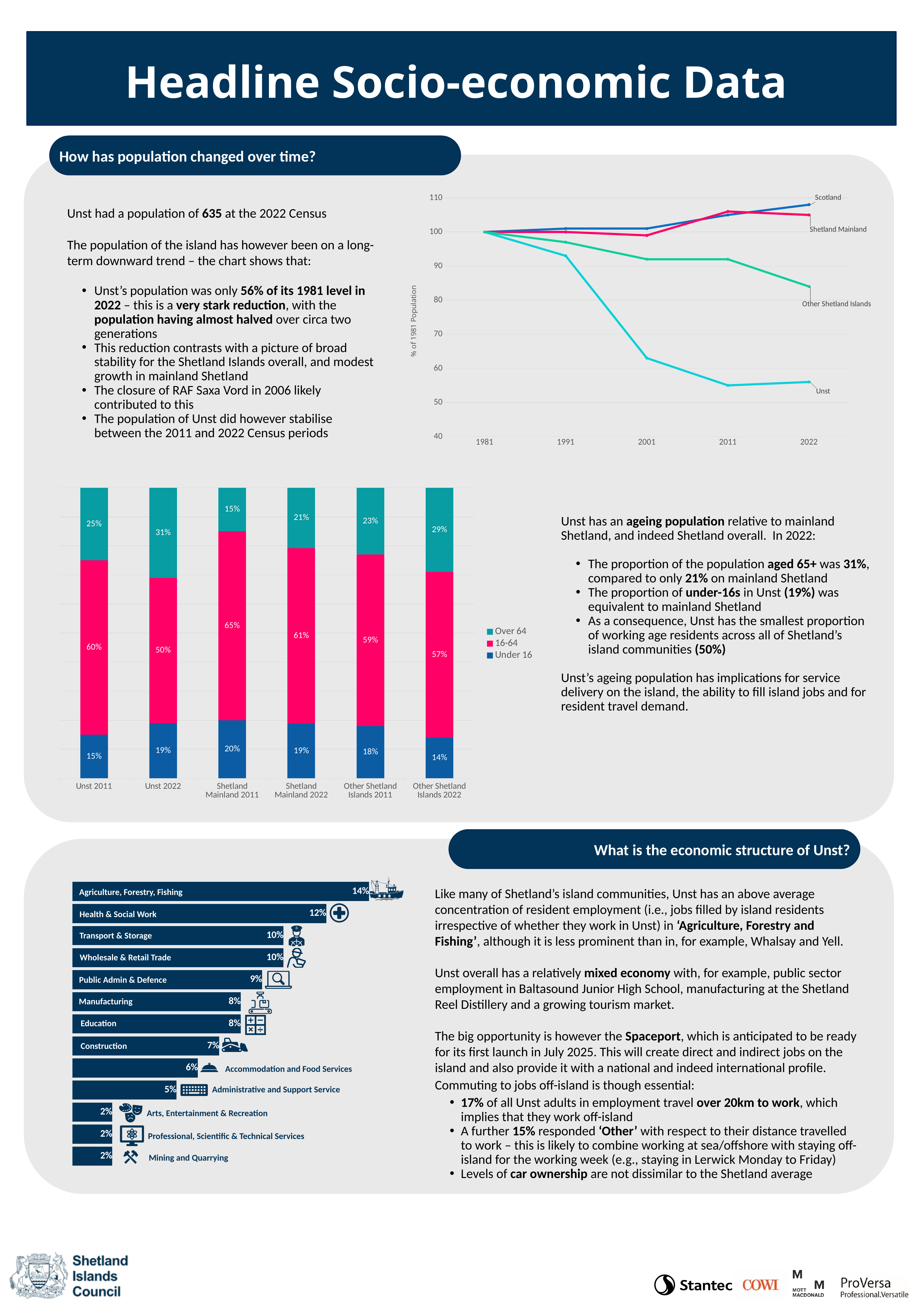
On the stacked bar chart of age structure, what percentage of the Shetland Mainland 2011 population is aged 16-64? 65% On the stacked bar chart of age structure, what is the difference in the 16-64 share between Unst 2011 and Unst 2022? 10 percentage points On the stacked bar chart of age structure, how many series does the legend list? 3 On the line chart of population as a percentage of 1981 levels, what kind of chart is it? line chart On the employment sector bar chart, which sector has the highest share? Agriculture, Forestry, Fishing On the line chart of population as a percentage of 1981 levels, how many census years are shown on the x axis? 5 On the line chart of population as a percentage of 1981 levels, does the Unst line rise or fall between 1981 and 2022? fall On the line chart of population as a percentage of 1981 levels, is the value for Scotland in 2022 greater or less than 100? greater On the stacked bar chart of age structure, which category has the lowest Under 16 share? Other Shetland Islands 2022 On the employment sector bar chart, what is the share for Public Admin & Defence? 9% On the line chart of population as a percentage of 1981 levels, is the value for Unst in 2022 greater or less than 60? less On the stacked bar chart of age structure, what percentage of the Unst 2022 population is Over 64? 31%